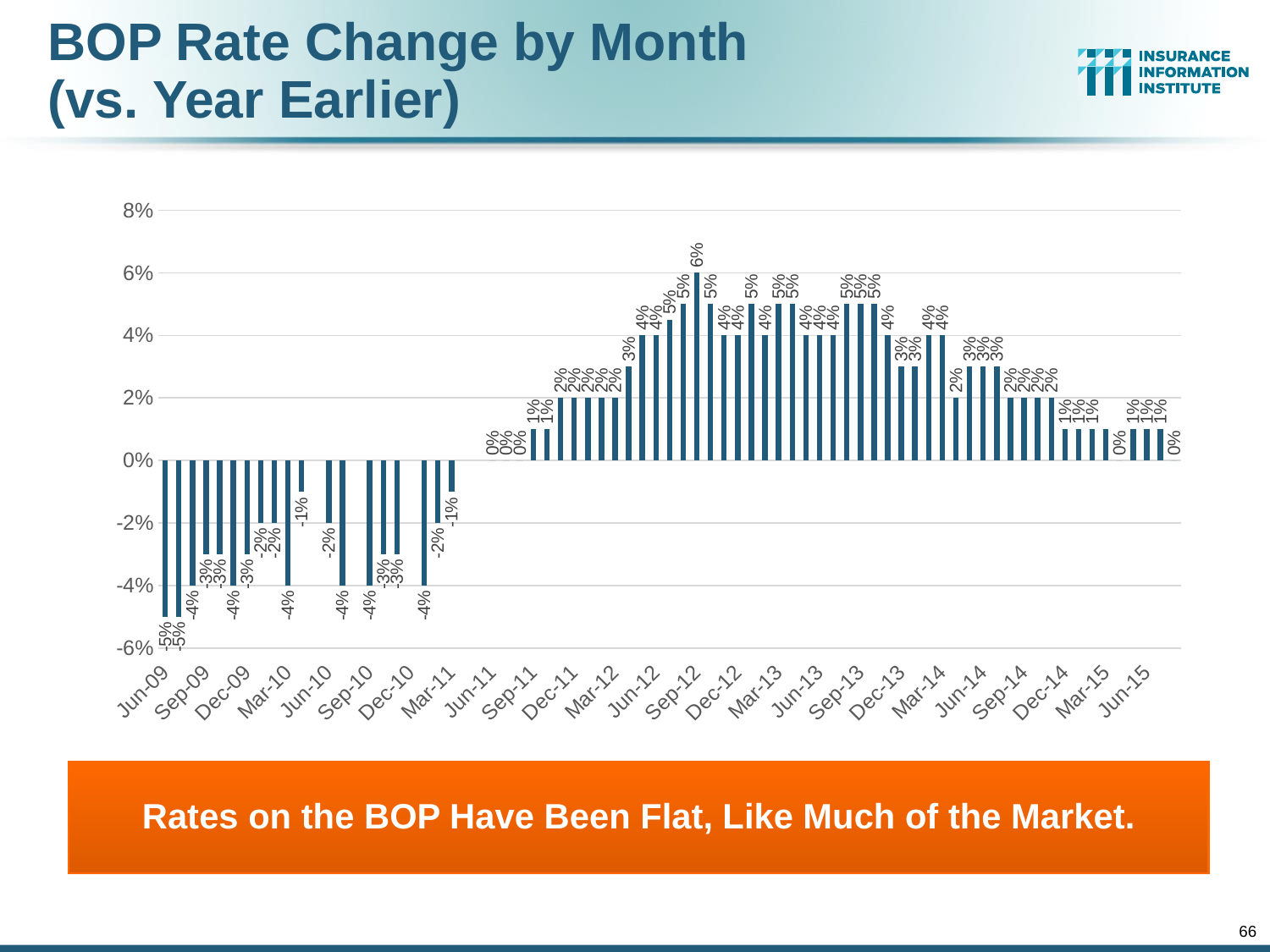
How many bars reach the 6% value? 1 What type of chart is shown on the slide? Bar chart What is the BOP rate change for Jun-09, the first month in the chart? -5% What is the lowest rate change value shown in the chart? -5% Is the rate change for Jun-09 greater or less than -4%? less Which is larger, the rate change for Jun-09 or for Jun-15? Jun-15 What is the difference between the highest value (6%) and the lowest value (-5%) in the chart? 11 percentage points What is the lowest value labelled on the vertical axis? -6% Do the rate change values generally rise or fall from Jun-09 to Jun-12? rise What is the title of the chart? BOP Rate Change by Month (vs. Year Earlier) What is the highest rate change value shown in the chart? 6%